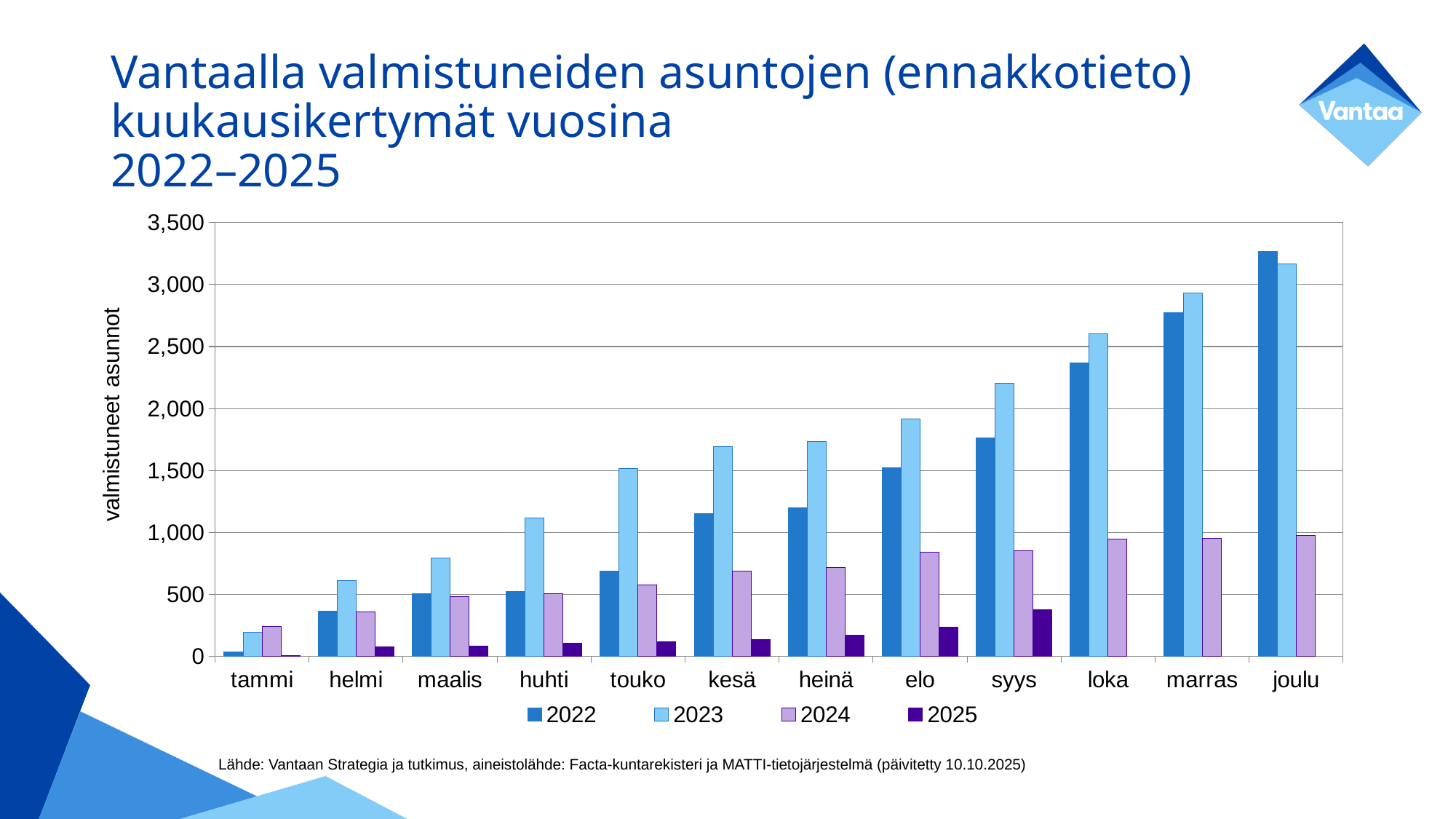
Do the values for the 2023 series rise or fall from tammi to joulu? rise Is the value for 2023 in kesä greater or less than 1,500? greater Which is larger in heinä, the value for 2023 or the value for 2024? 2023 How many month categories are shown on the x axis? 12 What kind of chart is shown on the slide? bar chart In which month is the 2022 series at its lowest? tammi In which month is the 2023 series at its highest? joulu Is the value for 2022 in loka greater or less than 2,000? greater In which month is the 2025 series at its highest? syys Is the value for 2025 in syys greater or less than 500? less How many series does the legend list? 4 What is the label on the vertical axis? valmistuneet asunnot